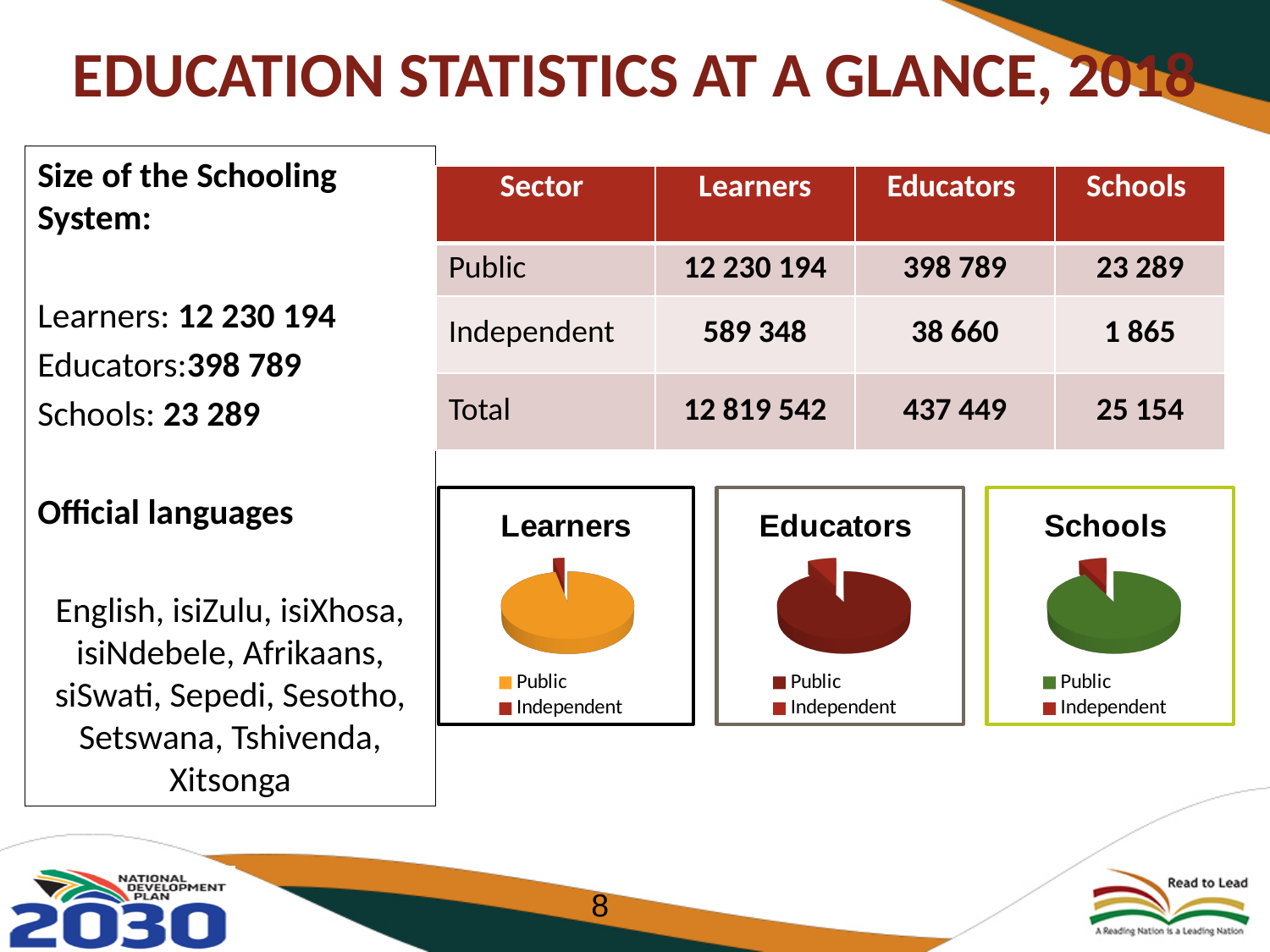
In the Educators pie chart, which slice is larger, Public or Independent? Public In the Educators pie chart, which sector has the smallest slice? Independent What is the title of the pie chart on the right of the slide? Schools In the Schools pie chart, which sector has the largest slice? Public What kind of chart is the Learners chart? pie chart How many slices does the Learners pie chart have? 2 How many pie charts are shown on the slide? 3 In the Learners pie chart, which sector has the largest slice? Public In the Schools pie chart, which slice is smaller, Public or Independent? Independent How many entries does the legend of the Educators pie chart list? 2 What kind of chart is the Schools chart? pie chart What colour is the Public slice in the Learners pie chart? orange